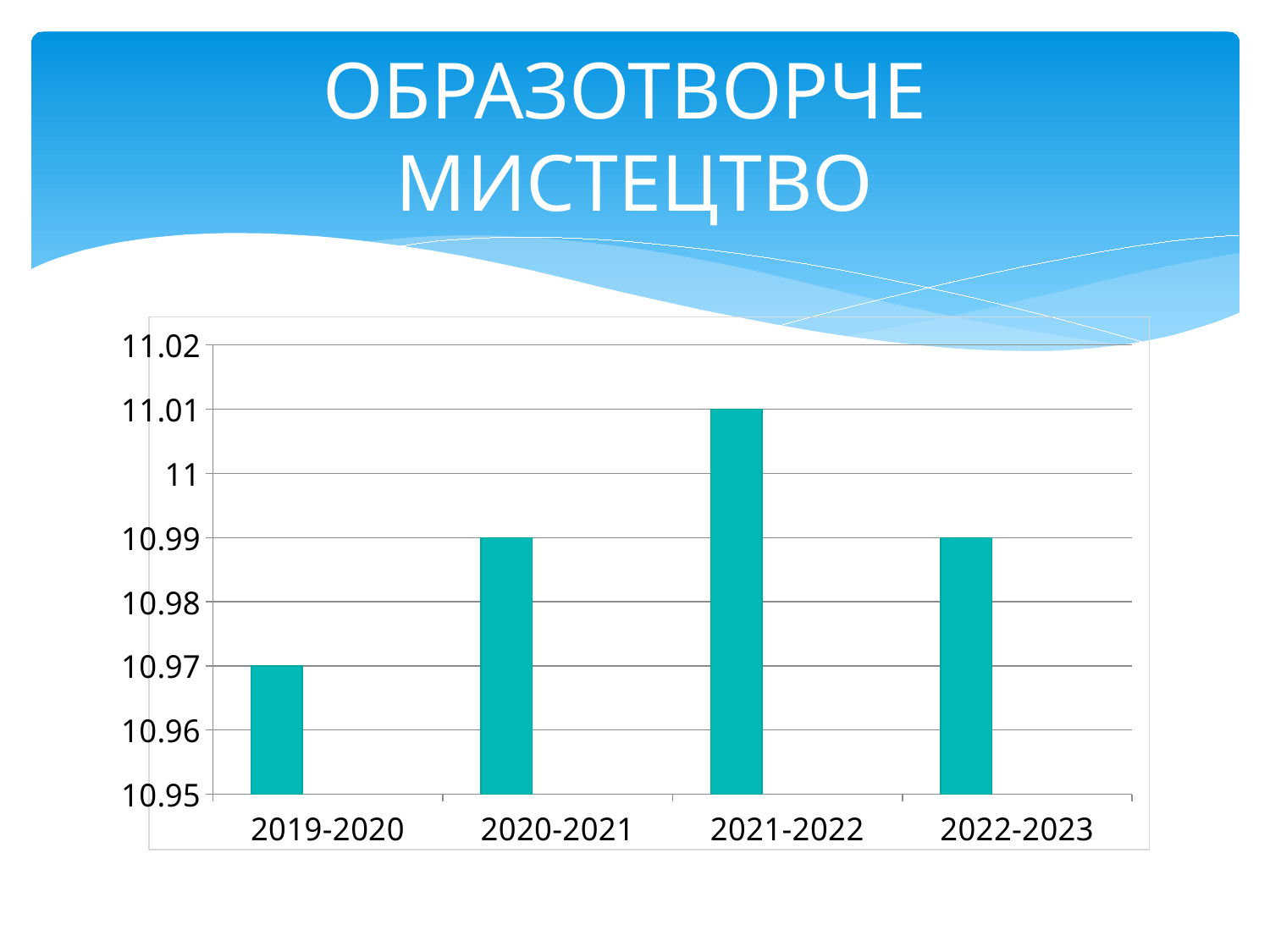
What kind of chart is shown on the slide? bar chart What is the value for 2022-2023? 10.99 Which is larger, the value for 2021-2022 or the value for 2022-2023? 2021-2022 What is the title shown at the top of the slide? ОБРАЗОТВОРЧЕ МИСТЕЦТВО Which school year has the highest value? 2021-2022 What is the difference between the values for 2021-2022 and 2019-2020? 0.04 What is the difference between the values for 2020-2021 and 2019-2020? 0.02 What is the value for 2021-2022? 11.01 Is the value for 2021-2022 greater or less than 11? greater What is the value for 2019-2020? 10.97 How many school years are shown on the x axis? 4 Which school year has the lowest value? 2019-2020